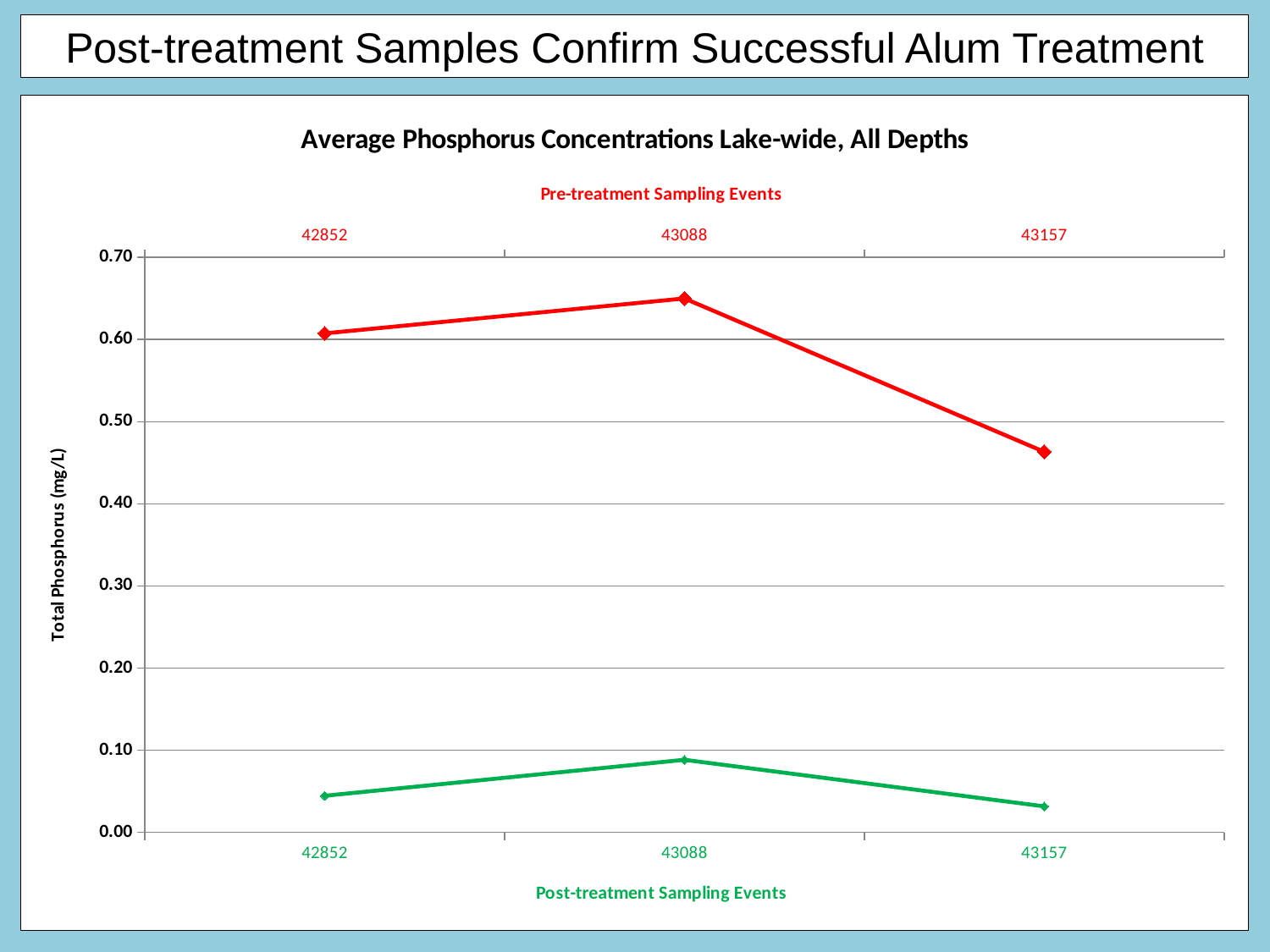
What kind of chart is shown on the slide? Line chart At which post-treatment sampling event is the green line highest? 43088 Which is larger at sampling event 43088: the pre-treatment value or the post-treatment value? Pre-treatment What is the label of the vertical axis? Total Phosphorus (mg/L) Is the pre-treatment value at 43157 greater or less than 0.50? less How many sampling events are plotted on the red pre-treatment line? 3 Does the red pre-treatment line rise or fall between 43088 and 43157? Fall At which pre-treatment sampling event is the red line lowest? 43157 What is the title of the chart? Average Phosphorus Concentrations Lake-wide, All Depths Is the post-treatment value at 43088 greater or less than 0.20? less At which pre-treatment sampling event is the red line highest? 43088 Is the pre-treatment value at 43088 greater or less than 0.60? greater